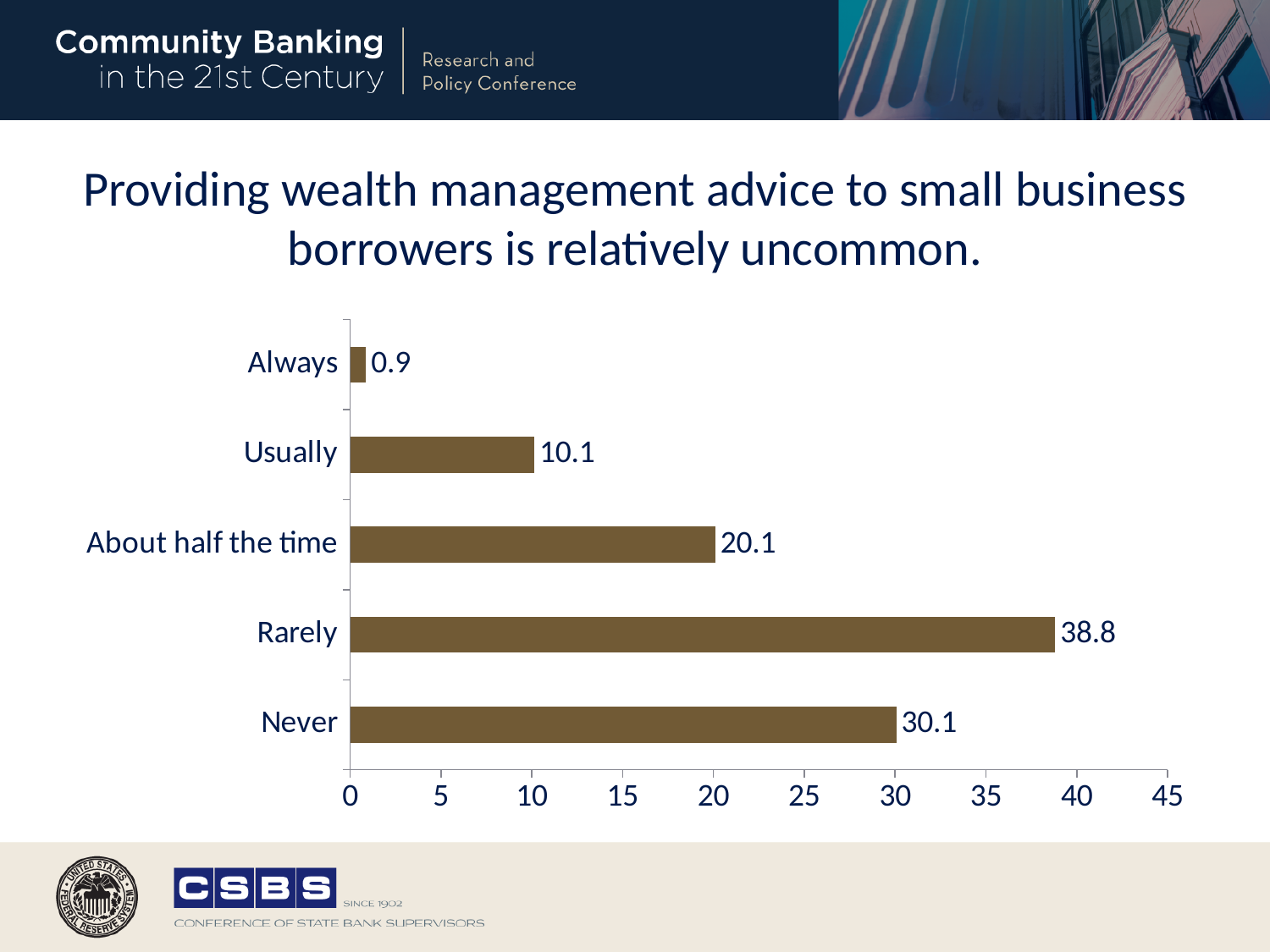
What kind of chart is shown on the slide? Bar chart What is the value for Always? 0.9 What is the difference between the values for Rarely and Never? 8.7 Is the value for Never greater or less than 25? greater Which category has the lowest value? Always What is the value for Usually? 10.1 Which is larger, the value for Usually or the value for About half the time? About half the time What is the value for About half the time? 20.1 What is the value for Never? 30.1 Which category has the highest value? Rarely What is the value for Rarely? 38.8 How many categories are shown in the chart? 5